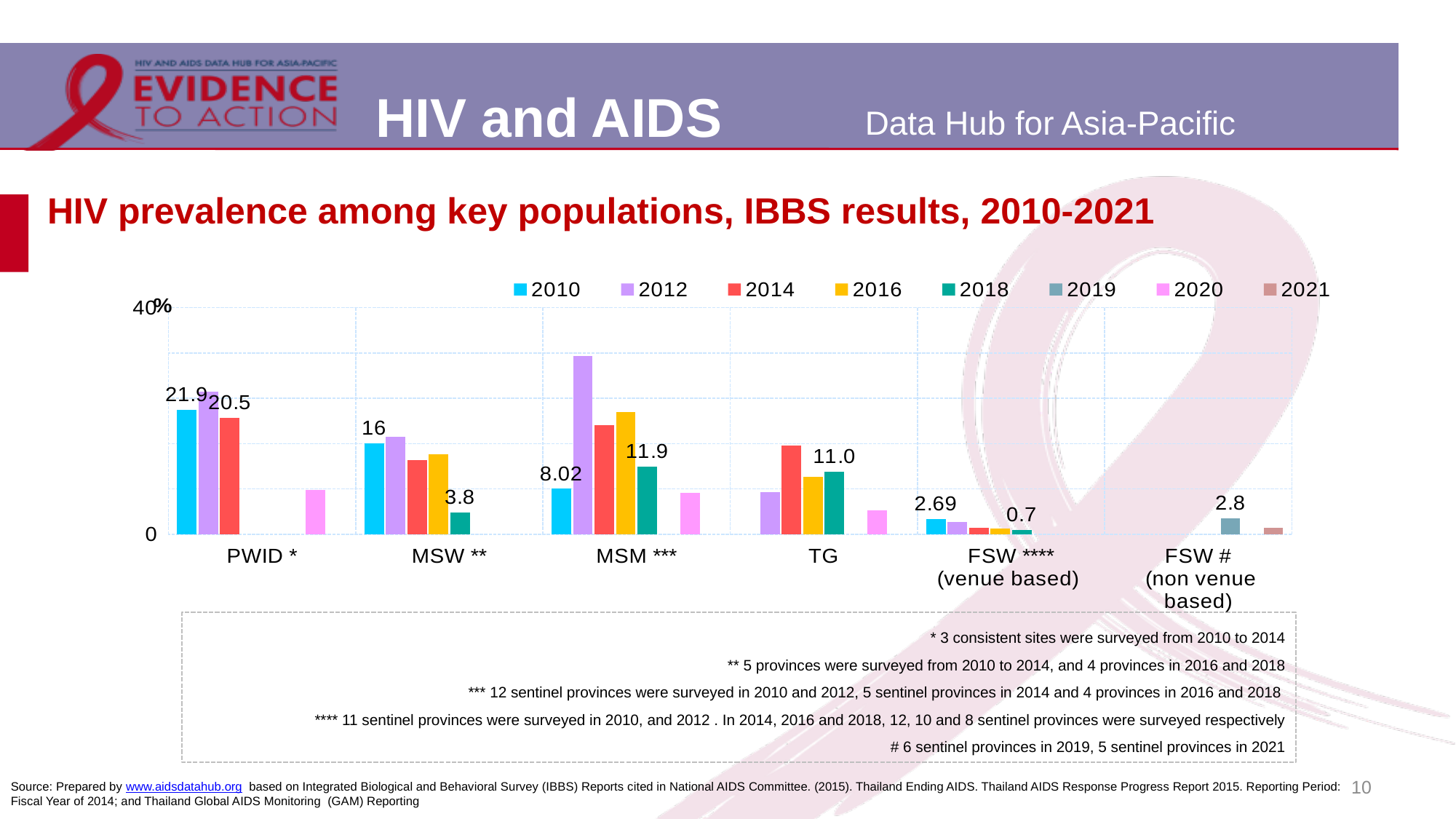
Which is larger, the HIV prevalence among MSM in 2010 or in 2018? 2018 How many series does the legend list? 8 What is the HIV prevalence among FSW (non venue based) in 2019? 2.8 How many key population categories are shown on the x axis? 6 What is the HIV prevalence among PWID in 2010? 21.9 Which key population has the tallest bar in the chart? MSM *** By how much did HIV prevalence among MSW fall from 2010 to 2018? 12.2 What is the HIV prevalence among MSW in 2010? 16 What is the HIV prevalence among MSW in 2018? 3.8 What is the HIV prevalence among MSM in 2010? 8.02 What kind of chart is shown on the slide? bar chart What is the HIV prevalence among TG in 2018? 11.0